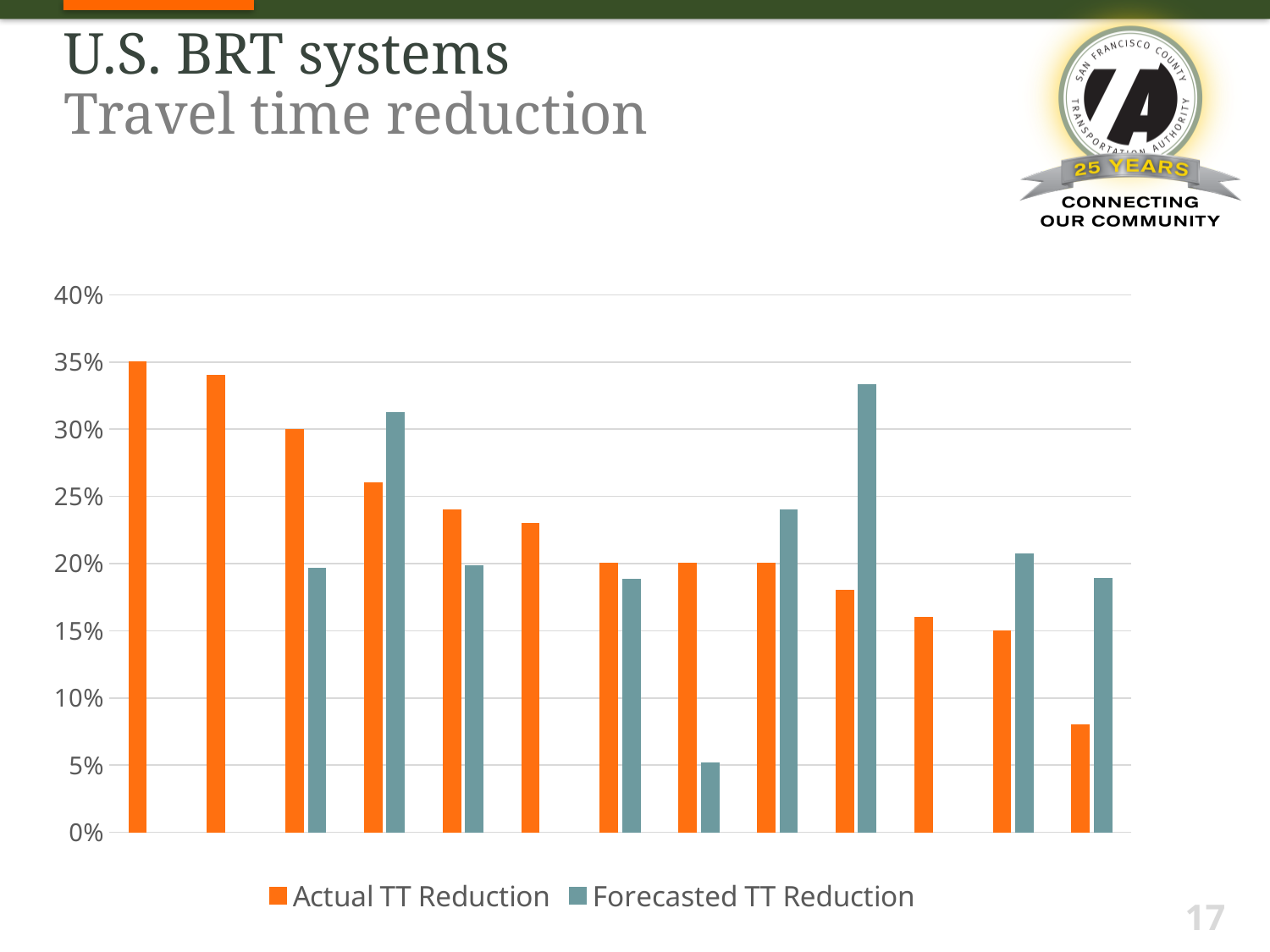
What kind of chart is shown on the slide? bar chart Is the rightmost Actual TT Reduction bar greater or less than 10%? less Is the leftmost Actual TT Reduction bar greater or less than 30%? greater How many series does the legend list? 2 How many Actual TT Reduction (orange) bars are plotted? 13 In the rightmost group of bars, which is larger: the Actual TT Reduction bar or the Forecasted TT Reduction bar? Forecasted TT Reduction Is the shortest Forecasted TT Reduction bar greater or less than 10%? less Do the Actual TT Reduction bars generally rise or fall from left to right? fall What are the two series named in the legend? Actual TT Reduction and Forecasted TT Reduction Which colour represents Forecasted TT Reduction in the chart? grey-blue How many Forecasted TT Reduction (grey) bars are plotted? 9